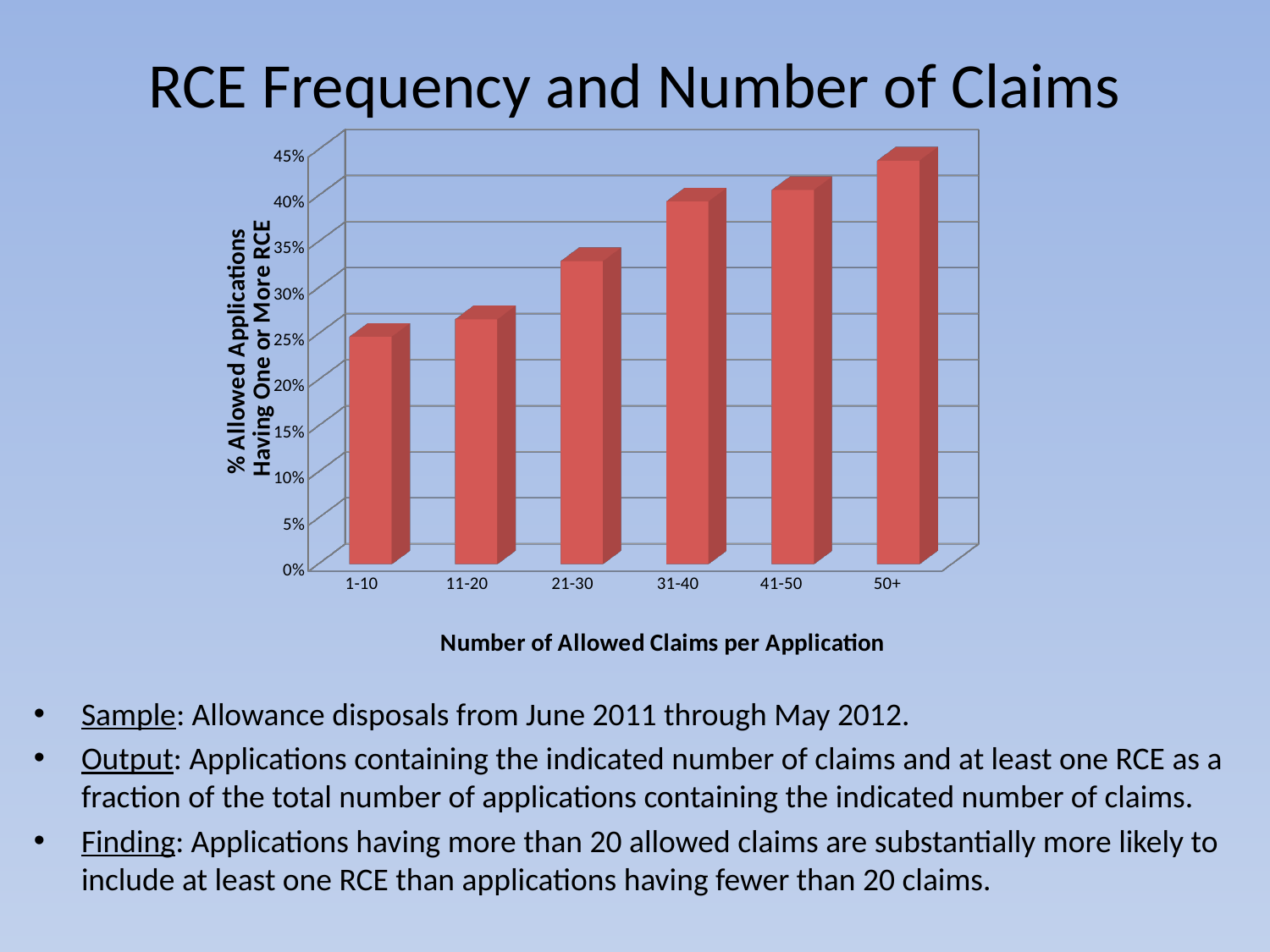
What kind of chart is shown on the slide? bar chart Which has a higher value, the 11-20 category or the 31-40 category? 31-40 How many claim-count categories are shown on the x axis? 6 Is the value for the 31-40 category greater or less than 35%? greater Is the value for the 1-10 category greater or less than 30%? less Is the value for the 11-20 category greater or less than 30%? less What is the title of the x axis? Number of Allowed Claims per Application Which category has the highest percentage of allowed applications having one or more RCE? 50+ Do the values rise or fall as the number of allowed claims per application increases along the x axis? rise Which category has the lowest percentage of allowed applications having one or more RCE? 1-10